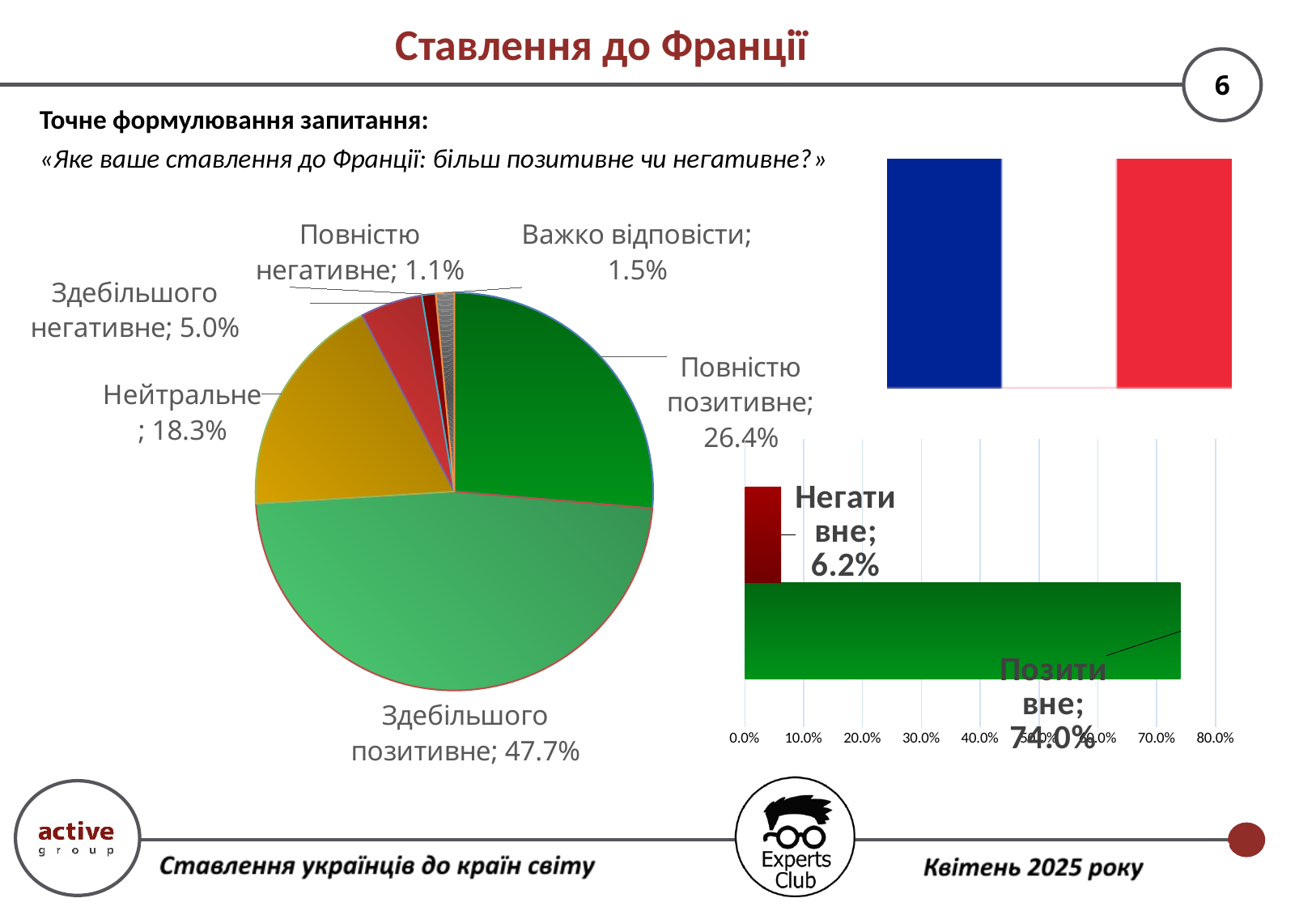
In the bar chart on the right, what is the value for "Негативне"? 6.2% In the pie chart on the left, which category has the smallest slice? Повністю негативне In the pie chart on the left, what share is labelled for "Повністю негативне"? 1.1% In the pie chart on the left, what share is labelled for "Здебільшого позитивне"? 47.7% In the bar chart on the right, what is the difference between "Позитивне" and "Негативне"? 67.8% In the pie chart on the left, which category has the largest slice? Здебільшого позитивне In the pie chart on the left, what share is labelled for "Нейтральне"? 18.3% What kind of chart is shown on the right side of the slide? Bar chart In the pie chart on the left, which is larger: "Здебільшого негативне" or "Важко відповісти"? Здебільшого негативне In the pie chart on the left, how many slices are there? 6 In the pie chart on the left, what is the difference between "Здебільшого позитивне" and "Повністю позитивне"? 21.3% In the bar chart on the right, what is the value for "Позитивне"? 74.0%